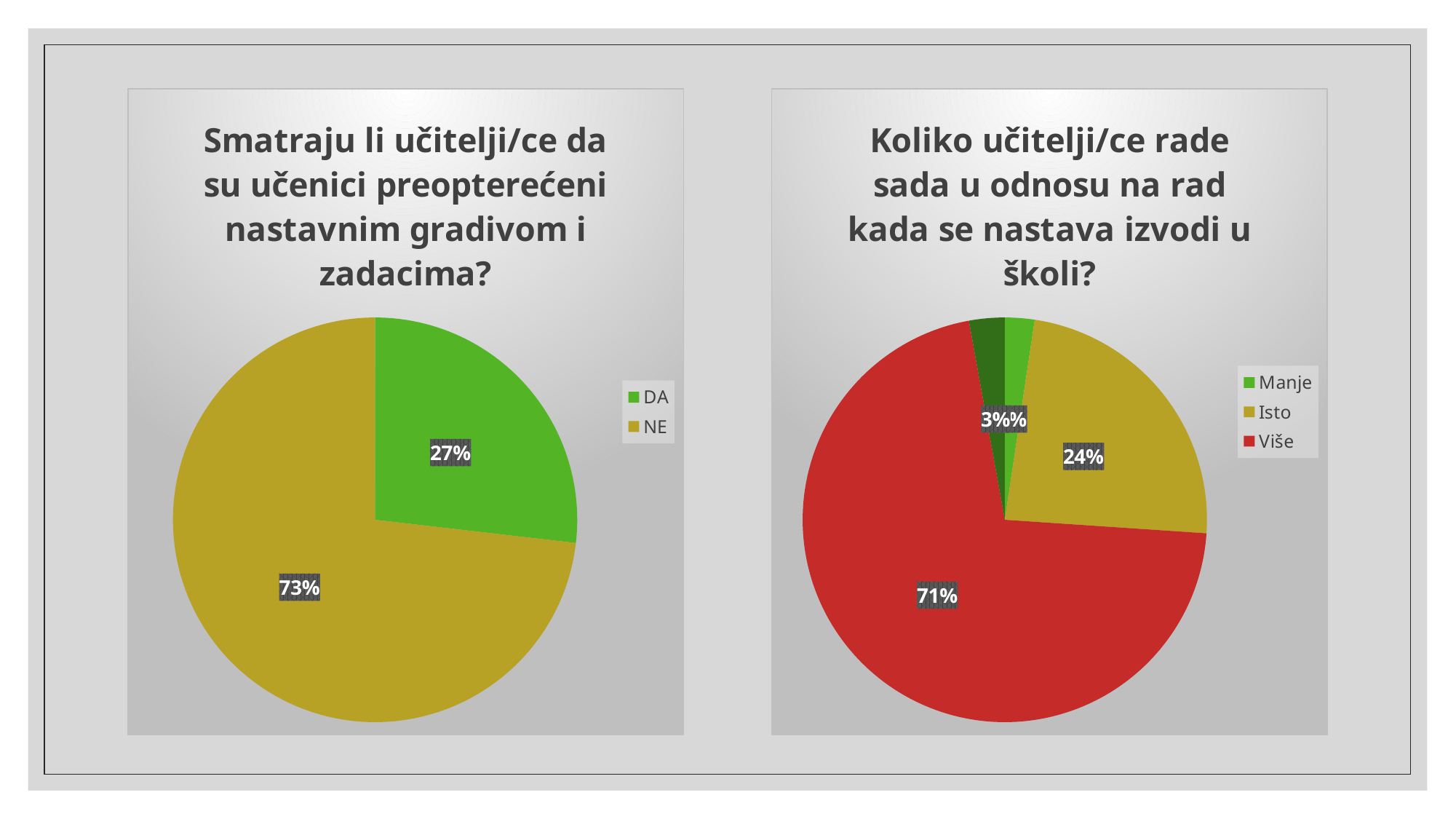
In the right pie chart ("Koliko učitelji/ce rade sada u odnosu na rad kada se nastava izvodi u školi?"), what percentage is shown for Isto? 24% How many entries does the legend of the right chart list? 3 In the right pie chart, which is larger, Isto or Više? Više In the left pie chart, by how many percentage points does NE exceed DA? 46 percentage points In the right pie chart, what colour is the Više slice? Red In the right pie chart, which category has the largest slice? Više What type of chart is the left chart on the slide? Pie chart How many entries does the legend of the left chart list? 2 In the right pie chart, what percentage is shown for Više? 71% In the left pie chart ("Smatraju li učitelji/ce da su učenici preopterećeni nastavnim gradivom i zadacima?"), what percentage is shown for DA? 27% In the left pie chart, what percentage is shown for NE? 73% In the left pie chart, which category has the largest slice? NE